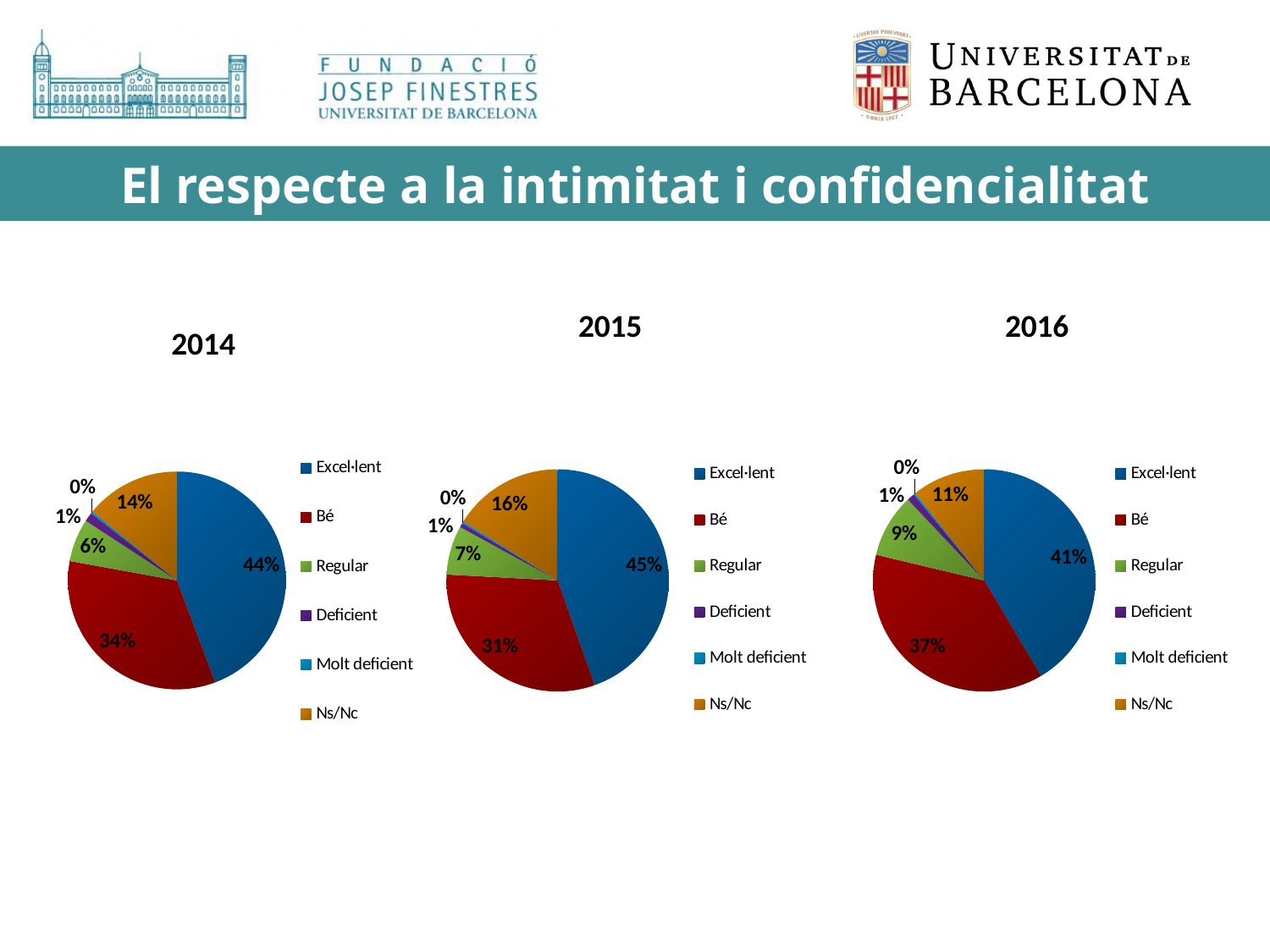
How many categories does the legend of the 2015 pie chart list? 6 In the 2014 pie chart, which is larger, the Ns/Nc share or the Regular share? Ns/Nc In the 2015 pie chart, which category has the largest share? Excel·lent In the 2015 pie chart, what is the difference between the Ns/Nc and Regular shares? 9% In the 2016 pie chart, what share does Regular have? 9% In the 2016 pie chart, what is the difference between the Excel·lent and Bé shares? 4% In the 2015 pie chart, what share does Bé have? 31% In the 2016 pie chart, what share does Ns/Nc have? 11% How many pie charts are shown on the slide? 3 In the 2014 pie chart, which category has the largest share? Excel·lent What type of chart is used for the 2016 data? Pie chart In the 2014 pie chart, what share does Excel·lent have? 44%